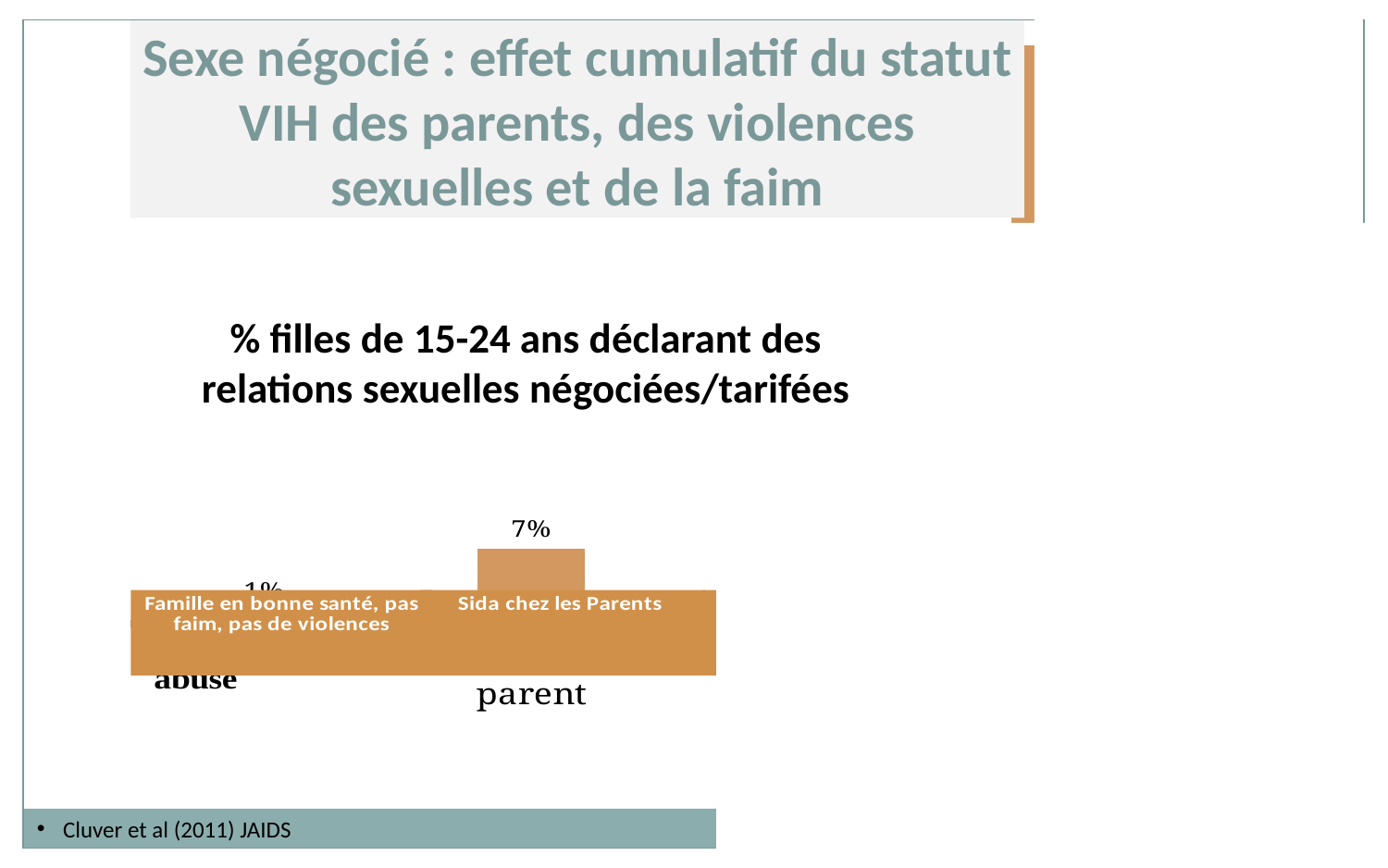
What kind of chart is shown on the slide? Bar chart Which is larger: the value for 'Sida chez les Parents' or for 'Famille en bonne santé, pas faim, pas de violences'? Sida chez les Parents Which category has the lowest value? Famille en bonne santé, pas faim, pas de violences How many categories are shown in the chart? 2 Which category has the highest value? Sida chez les Parents What is the value for 'Sida chez les Parents'? 7% What is the value for 'Famille en bonne santé, pas faim, pas de violences'? 1% What is the difference between the value for 'Sida chez les Parents' and the value for 'Famille en bonne santé, pas faim, pas de violences'? 6% What is the title of the chart? % filles de 15-24 ans déclarant des relations sexuelles négociées/tarifées What source is cited at the bottom of the slide? Cluver et al (2011) JAIDS